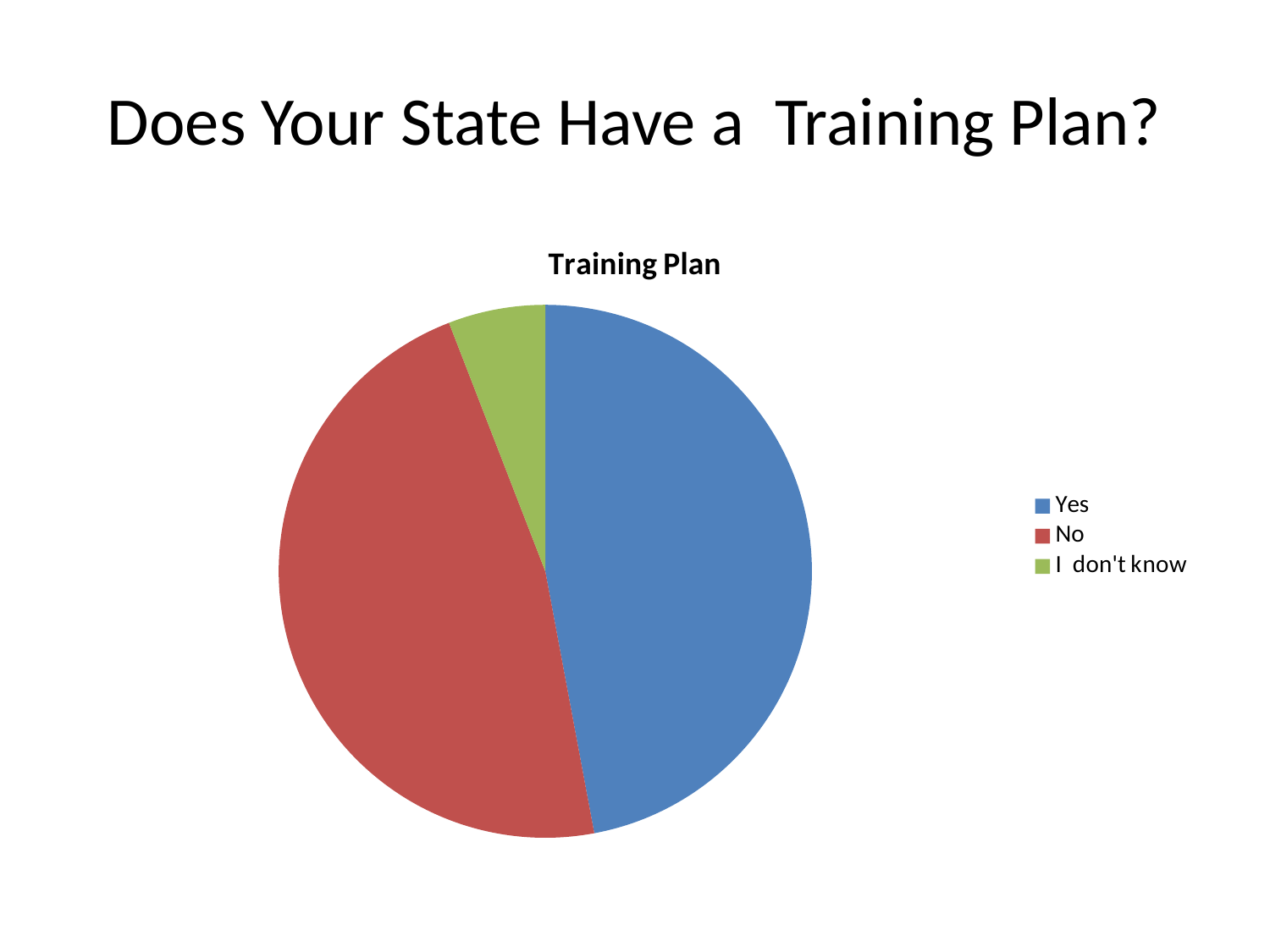
What colour is the No slice? red How many slices does the pie chart have? 3 Which slice is larger, No or I don't know? No Which slice is larger, Yes or I don't know? Yes Which category has the largest slice of the pie? Yes What kind of chart is shown on the slide? pie chart Which category has the smallest slice of the pie? I don't know What is the title of the chart? Training Plan Which slice is larger, Yes or No? Yes How many entries does the legend list? 3